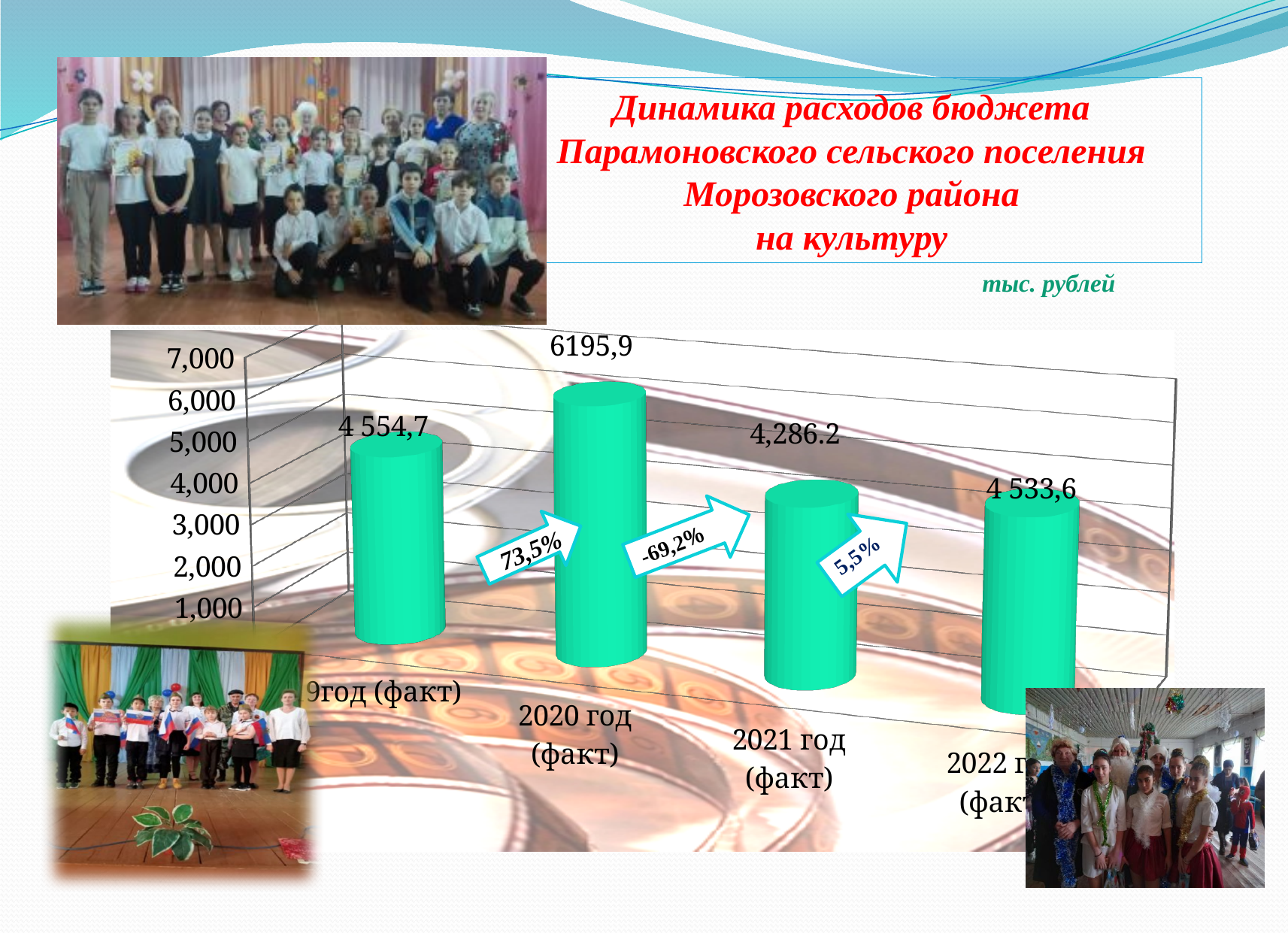
How many bars are plotted in the chart? 4 What is the value for 2020 год (факт)? 6195,9 Which year has the lowest value in the chart? 2021 год (факт) Which year has the highest value in the chart? 2020 год (факт) What kind of chart is shown on the slide? bar chart What percentage change is shown on the arrow between 2020 год (факт) and 2021 год (факт)? -69,2% Which is larger, the value for 2020 год (факт) or for 2021 год (факт)? 2020 год (факт) What is the difference between the values for 2020 год (факт) and 2022 год (факт)? 1662,3 What is the value for 2022 год (факт)? 4 533,6 Is the value for 2020 год (факт) greater or less than 6,000? greater What is the value shown on the leftmost bar of the chart? 4 554,7 What is the value for 2021 год (факт)? 4,286.2